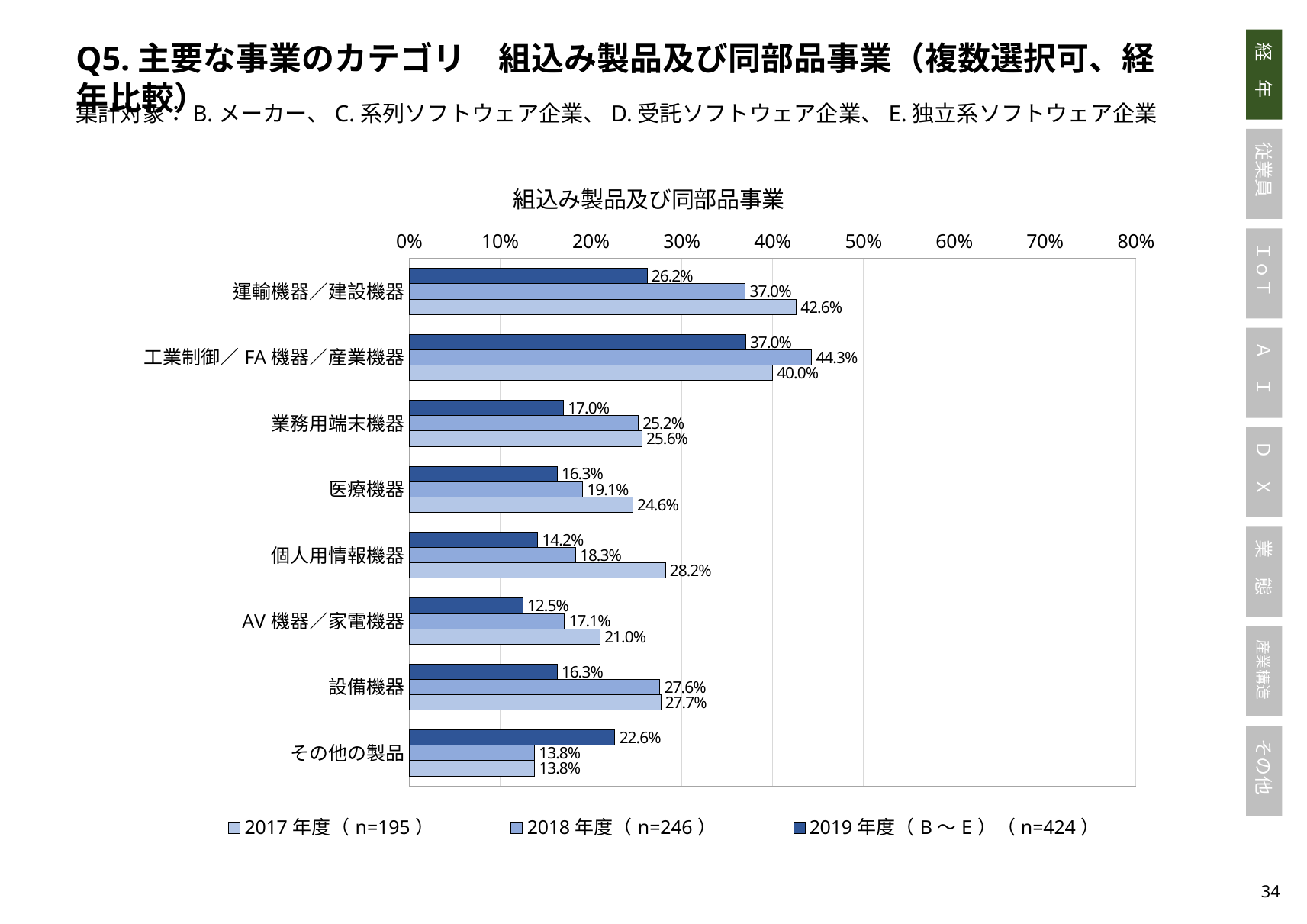
What is the 2017年度 value for 個人用情報機器? 28.2% What is the difference between the 2017年度 and 2019年度 values for 運輸機器／建設機器? 16.4% How many categories are shown on the chart? 8 What is the 2018年度 value for 工業制御／FA機器／産業機器? 44.3% What is the title of the chart? 組込み製品及び同部品事業 What is the 2019年度 value for 運輸機器／建設機器? 26.2% For その他の製品, which is larger: the 2019年度 value or the 2018年度 value? 2019年度 What type of chart is shown on the slide? bar chart How many series does the legend list? 3 Which category has the lowest 2019年度 value? AV機器／家電機器 Which category has the highest 2019年度 value? 工業制御／FA機器／産業機器 Is the 2018年度 value for 医療機器 greater or less than 20%? less